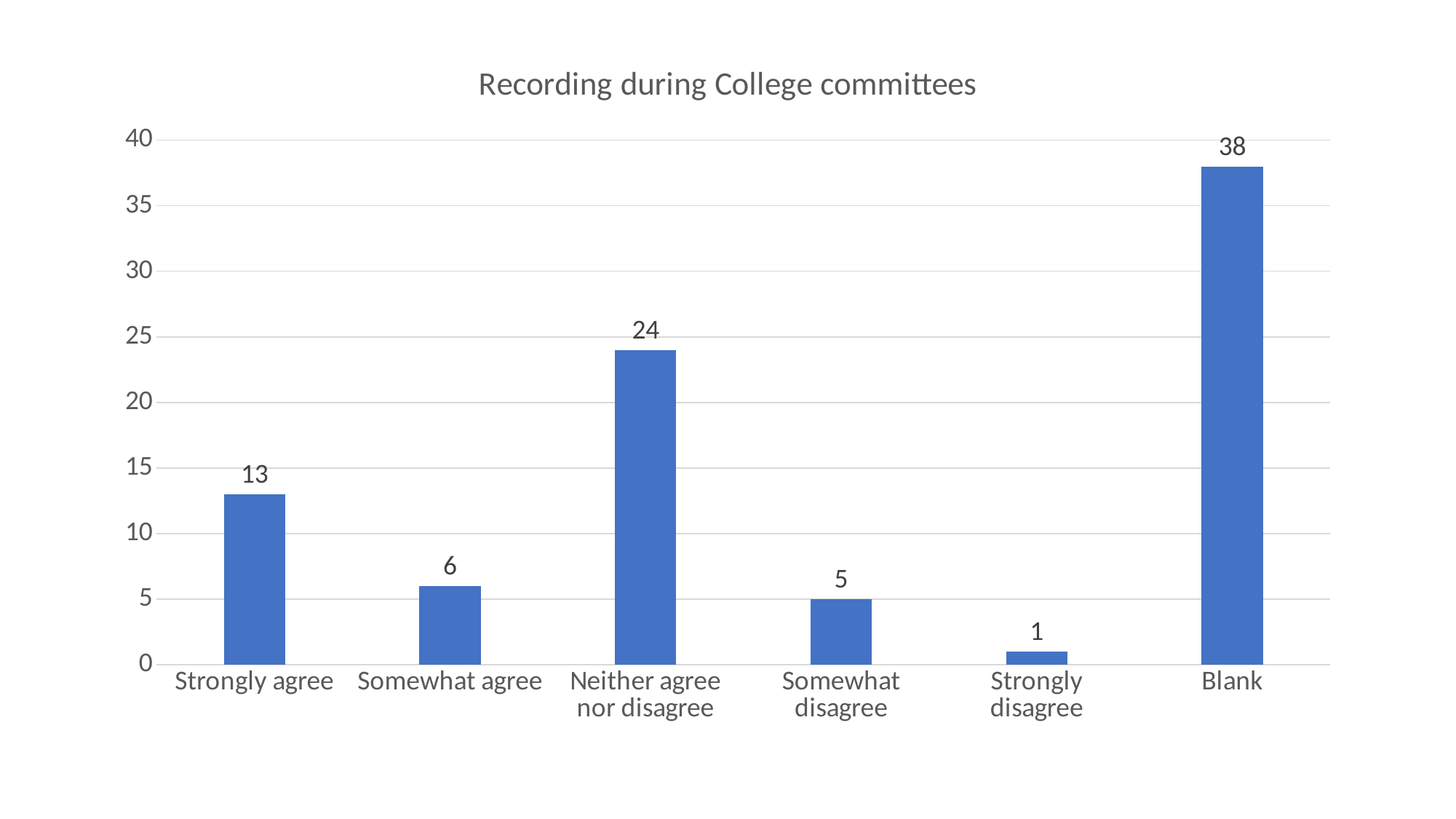
Which category has the lowest value? Strongly disagree How many categories are shown on the x axis? 6 Which is larger, the value for Somewhat agree or the value for Somewhat disagree? Somewhat agree What is the value for Blank? 38 What is the value for Strongly disagree? 1 What is the difference between the values for Blank and Neither agree nor disagree? 14 What kind of chart is this? Bar chart What is the value for Neither agree nor disagree? 24 What is the difference between the values for Strongly agree and Somewhat agree? 7 What is the value for Strongly agree? 13 Which category has the highest value? Blank What is the title of the chart? Recording during College committees